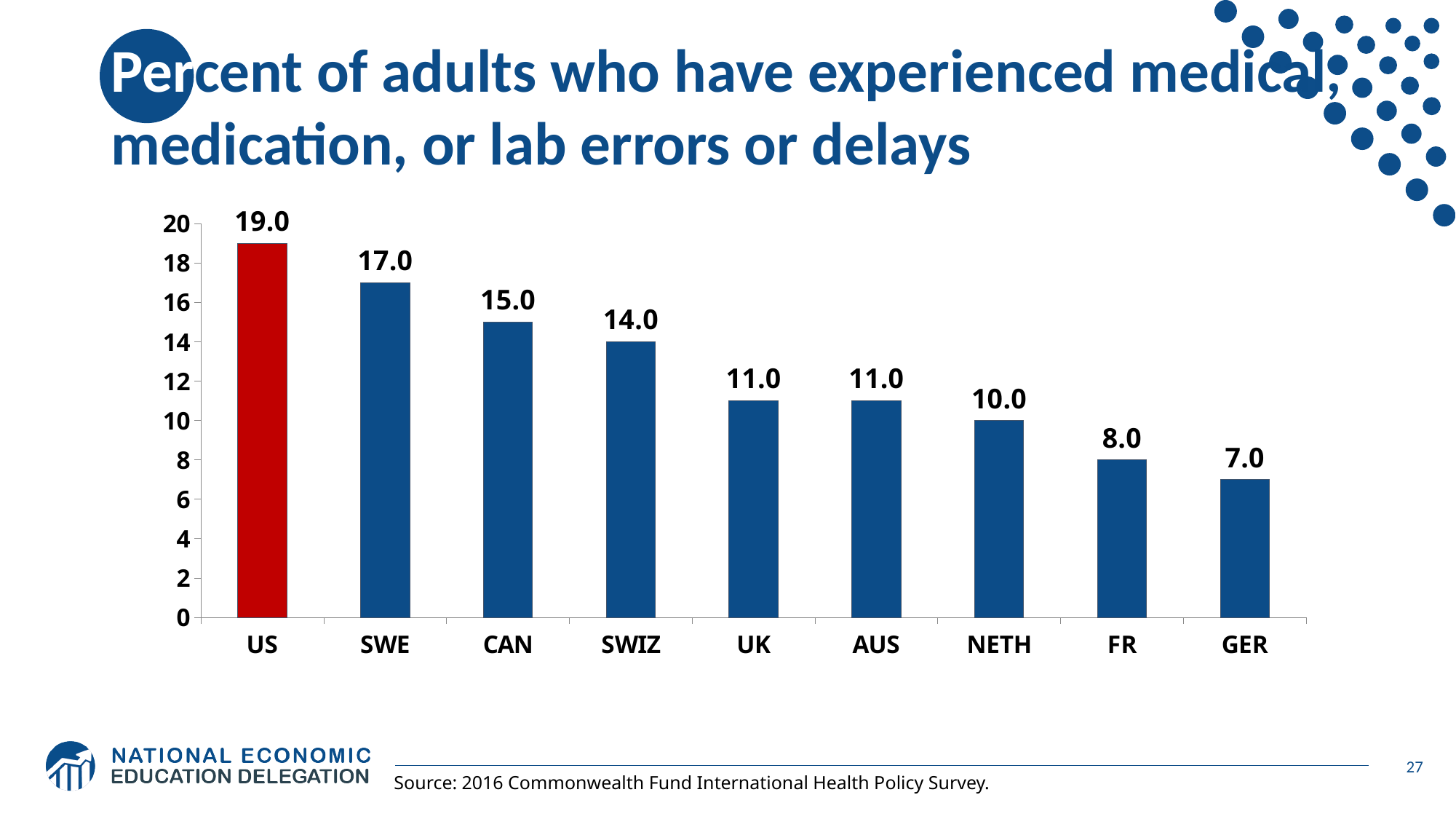
What kind of chart is shown on the slide? Bar chart What is the value for the US? 19.0 What is the value for NETH? 10.0 What is the difference between the values for the US and GER? 12.0 Which bar is coloured red rather than blue? US What is the value for SWIZ? 14.0 Which country has the highest value? US Do the values rise or fall moving from left to right along the x axis? Fall Which is larger, the value for FR or the value for NETH? NETH What is the difference between the values for SWE and CAN? 2.0 How many countries are shown on the chart? 9 Which country has the lowest value? GER